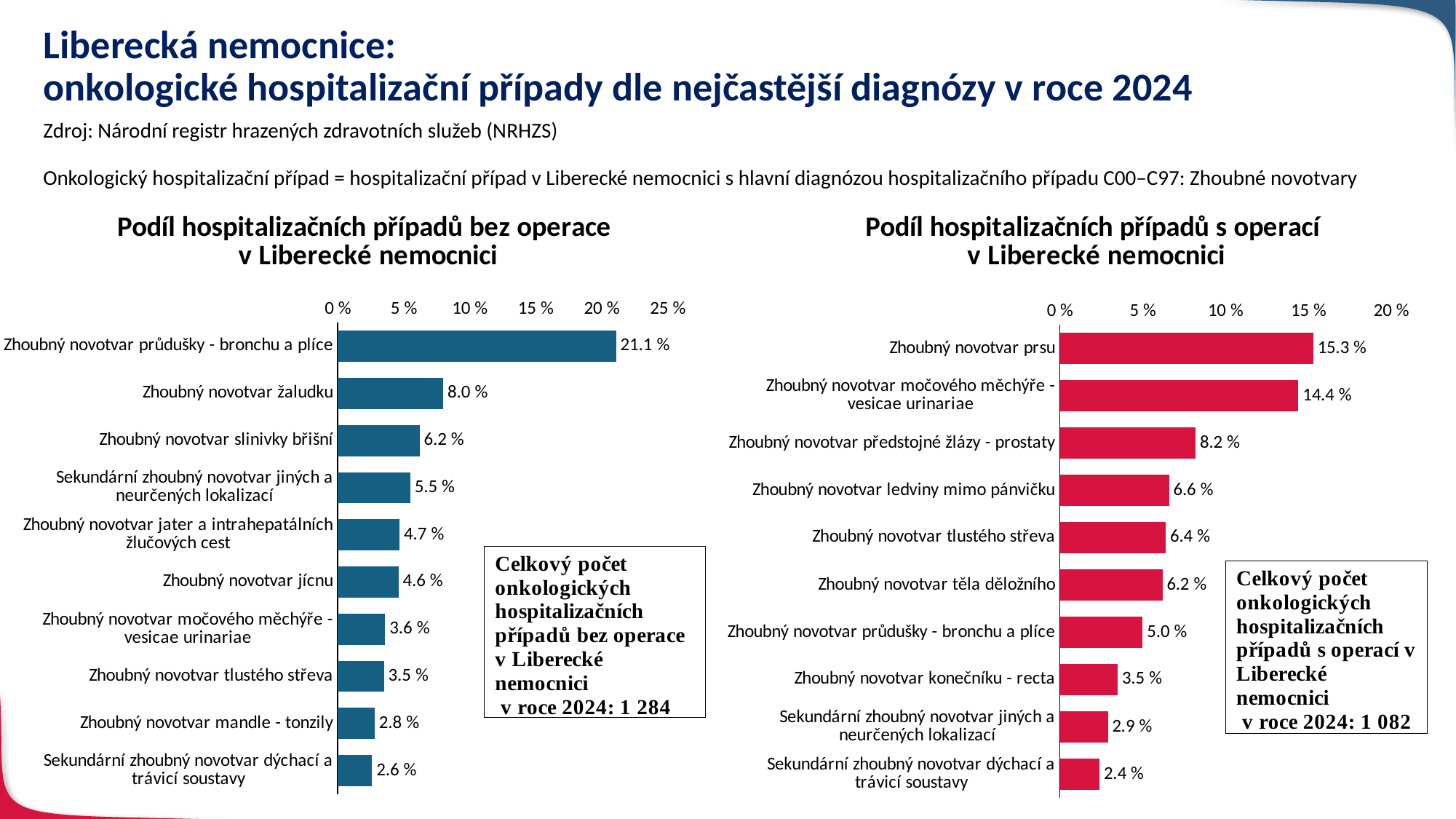
In the left chart 'Podíl hospitalizačních případů bez operace v Liberecké nemocnici', is the value for 'Zhoubný novotvar žaludku' greater or less than 10 %? less How many categories are shown in the right chart 'Podíl hospitalizačních případů s operací v Liberecké nemocnici'? 10 In the left chart 'Podíl hospitalizačních případů bez operace v Liberecké nemocnici', what is the difference between 'Zhoubný novotvar průdušky - bronchu a plíce' and 'Zhoubný novotvar žaludku'? 13.1 % In the right chart 'Podíl hospitalizačních případů s operací v Liberecké nemocnici', what is the value for 'Zhoubný novotvar předstojné žlázy - prostaty'? 8.2 % In the right chart 'Podíl hospitalizačních případů s operací v Liberecké nemocnici', which is larger: 'Zhoubný novotvar ledviny mimo pánvičku' or 'Zhoubný novotvar průdušky - bronchu a plíce'? Zhoubný novotvar ledviny mimo pánvičku In the left chart 'Podíl hospitalizačních případů bez operace v Liberecké nemocnici', what is the value for 'Zhoubný novotvar průdušky - bronchu a plíce'? 21.1 % In the right chart 'Podíl hospitalizačních případů s operací v Liberecké nemocnici', which category has the highest value? Zhoubný novotvar prsu In the left chart 'Podíl hospitalizačních případů bez operace v Liberecké nemocnici', which category has the lowest value? Sekundární zhoubný novotvar dýchací a trávicí soustavy How many categories are shown in the left chart 'Podíl hospitalizačních případů bez operace v Liberecké nemocnici'? 10 What type of chart is the right chart 'Podíl hospitalizačních případů s operací v Liberecké nemocnici'? Bar chart According to the text box next to the left chart, what is the total number of oncological hospitalization cases without surgery in Liberecká nemocnice in 2024? 1 284 In the right chart 'Podíl hospitalizačních případů s operací v Liberecké nemocnici', what is the difference between 'Zhoubný novotvar prsu' and 'Zhoubný novotvar močového měchýře - vesicae urinariae'? 0.9 %